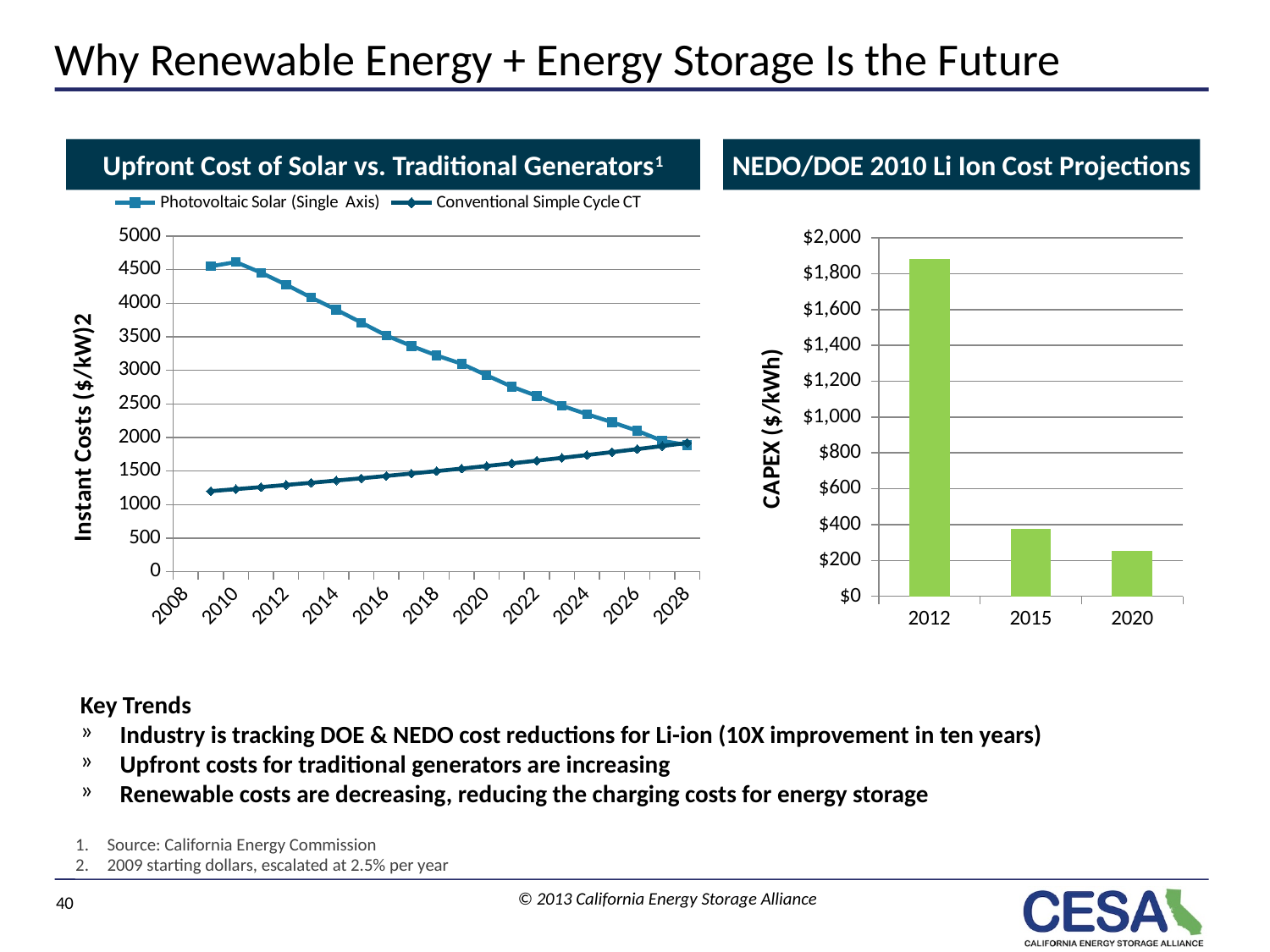
In the NEDO/DOE 2010 Li Ion Cost Projections chart, is the value for 2012 greater or less than $1,600? greater In the Upfront Cost of Solar vs. Traditional Generators chart, does the Photovoltaic Solar (Single Axis) line rise or fall from 2010 to 2028? fall What kind of chart is the Upfront Cost of Solar vs. Traditional Generators chart? line chart In the NEDO/DOE 2010 Li Ion Cost Projections chart, which year has the highest CAPEX? 2012 In the NEDO/DOE 2010 Li Ion Cost Projections chart, which year has the lowest CAPEX? 2020 What kind of chart is the NEDO/DOE 2010 Li Ion Cost Projections chart? bar chart In the Upfront Cost of Solar vs. Traditional Generators chart, which series has the higher value in 2010? Photovoltaic Solar (Single Axis) How many series does the legend of the Upfront Cost of Solar vs. Traditional Generators chart list? 2 In the Upfront Cost of Solar vs. Traditional Generators chart, does the Conventional Simple Cycle CT line rise or fall over time? rise How many years are shown on the x axis of the NEDO/DOE 2010 Li Ion Cost Projections chart? 3 In the NEDO/DOE 2010 Li Ion Cost Projections chart, is the value for 2015 greater or less than $600? less In the NEDO/DOE 2010 Li Ion Cost Projections chart, is the value for 2020 greater or less than $400? less